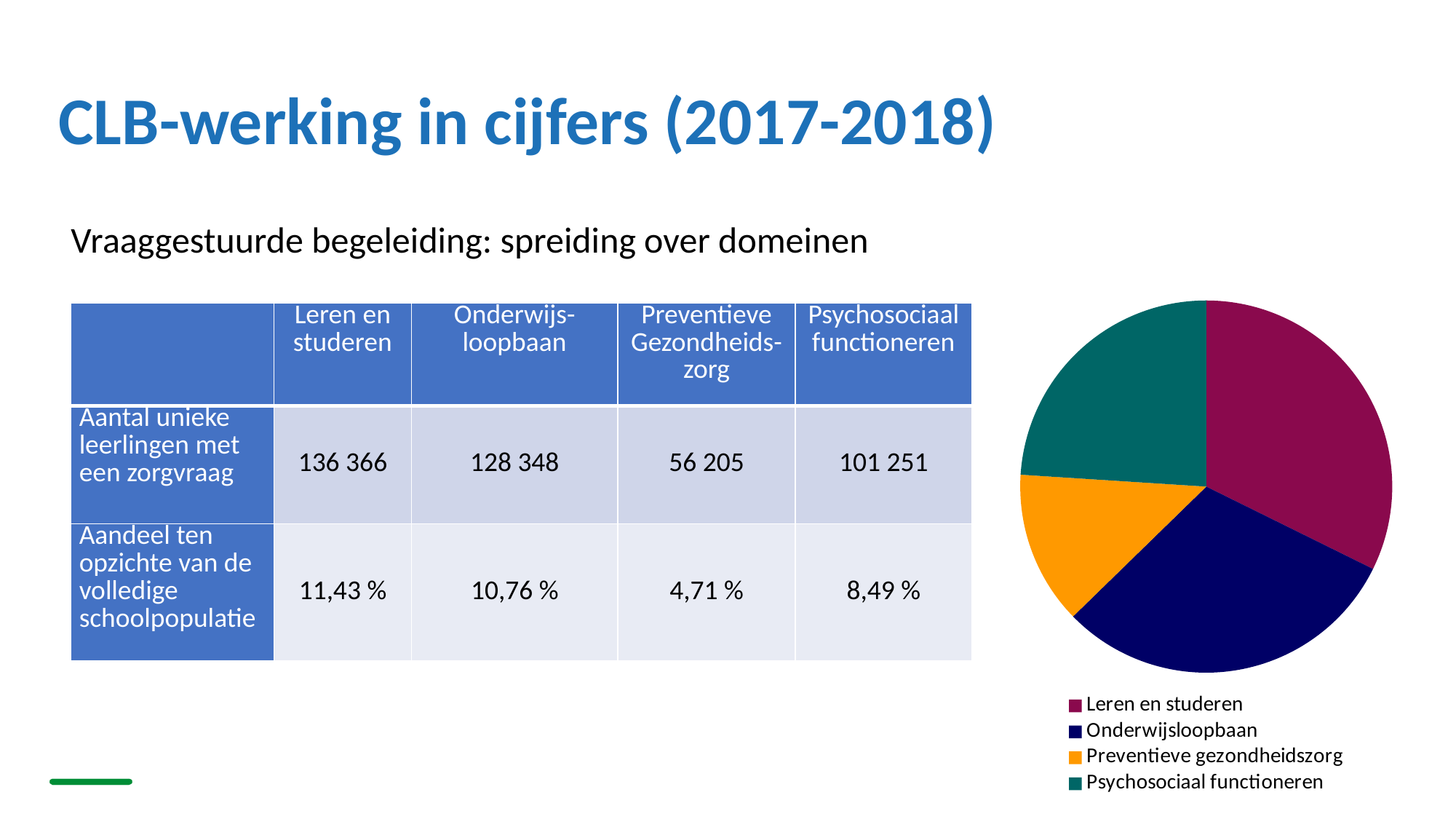
Which category has the largest slice in the pie chart? Leren en studeren Which colour represents Preventieve gezondheidszorg in the pie chart? orange Which category is shown in dark blue in the pie chart? Onderwijsloopbaan How many slices does the pie chart have? 4 Which category has the smallest slice in the pie chart? Preventieve gezondheidszorg In the pie chart, which slice is larger: Onderwijsloopbaan or Psychosociaal functioneren? Onderwijsloopbaan What kind of chart is shown on the right of the slide? pie chart According to the table, how many unique pupils with a care question are there for Leren en studeren? 136 366 How many entries does the pie chart's legend list? 4 According to the table, how many unique pupils with a care question are there for Psychosociaal functioneren? 101 251 According to the table, what share of the full school population does Preventieve Gezondheidszorg represent? 4,71 % In the pie chart, which slice is larger: Psychosociaal functioneren or Preventieve gezondheidszorg? Psychosociaal functioneren